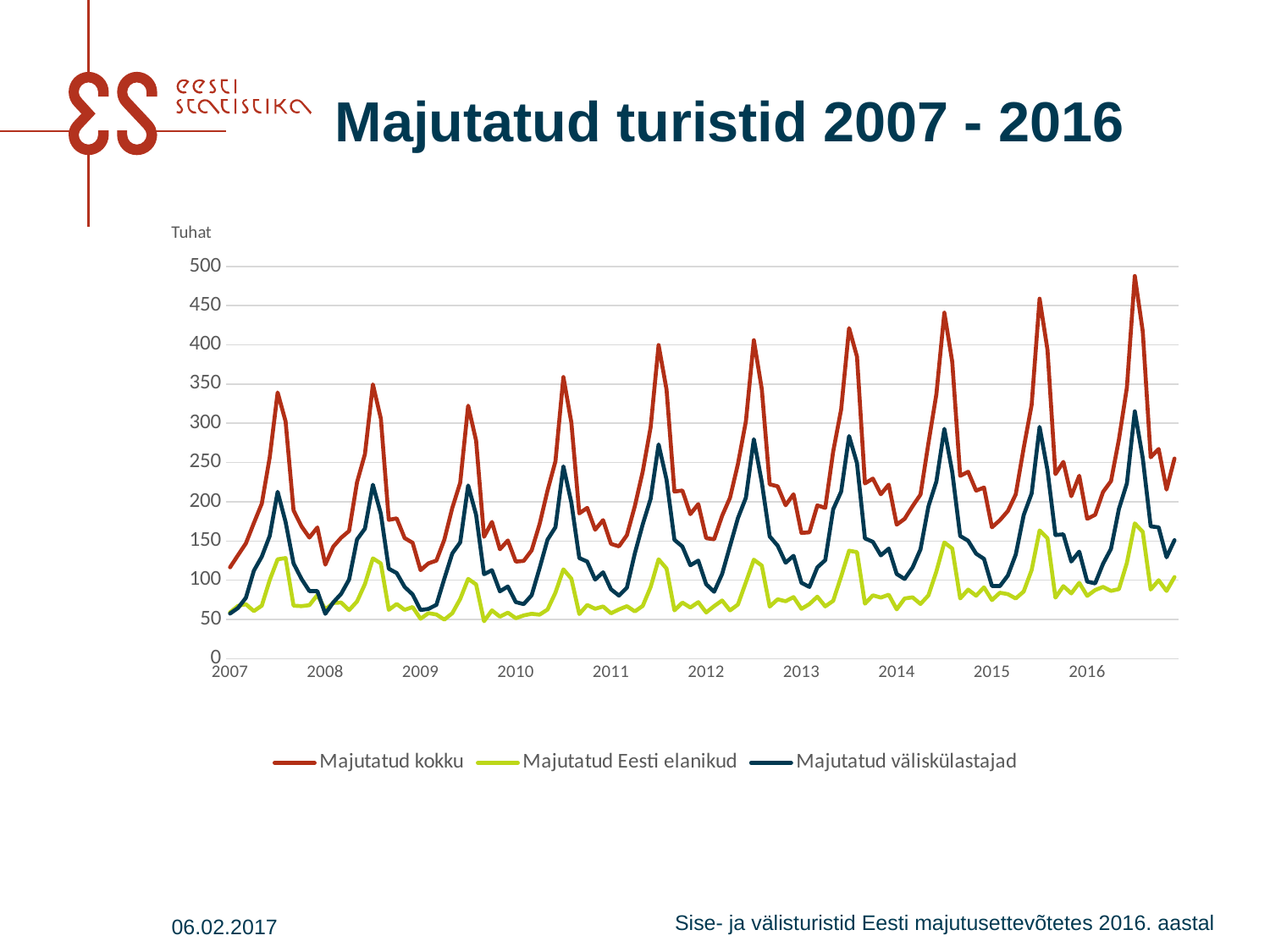
How many series does the legend list? 3 Is the highest peak of the Majutatud väliskülastajad series greater or less than 300? greater Which series has the lowest values throughout the chart? Majutatud Eesti elanikud Is the highest peak of the Majutatud Eesti elanikud series greater or less than 200? less In which year does the Majutatud kokku series reach its highest peak? 2016 At the 2016 summer peak, which series is larger: Majutatud väliskülastajad or Majutatud Eesti elanikud? Majutatud väliskülastajad What unit label is shown above the vertical axis? Tuhat What is the title of the chart on the slide? Majutatud turistid 2007 - 2016 Do the summer peaks of the Majutatud kokku series generally rise or fall from 2007 to 2016? rise What kind of chart is shown on the slide? line chart Which series is drawn in red? Majutatud kokku Is the highest peak of the Majutatud kokku series greater or less than 450? greater